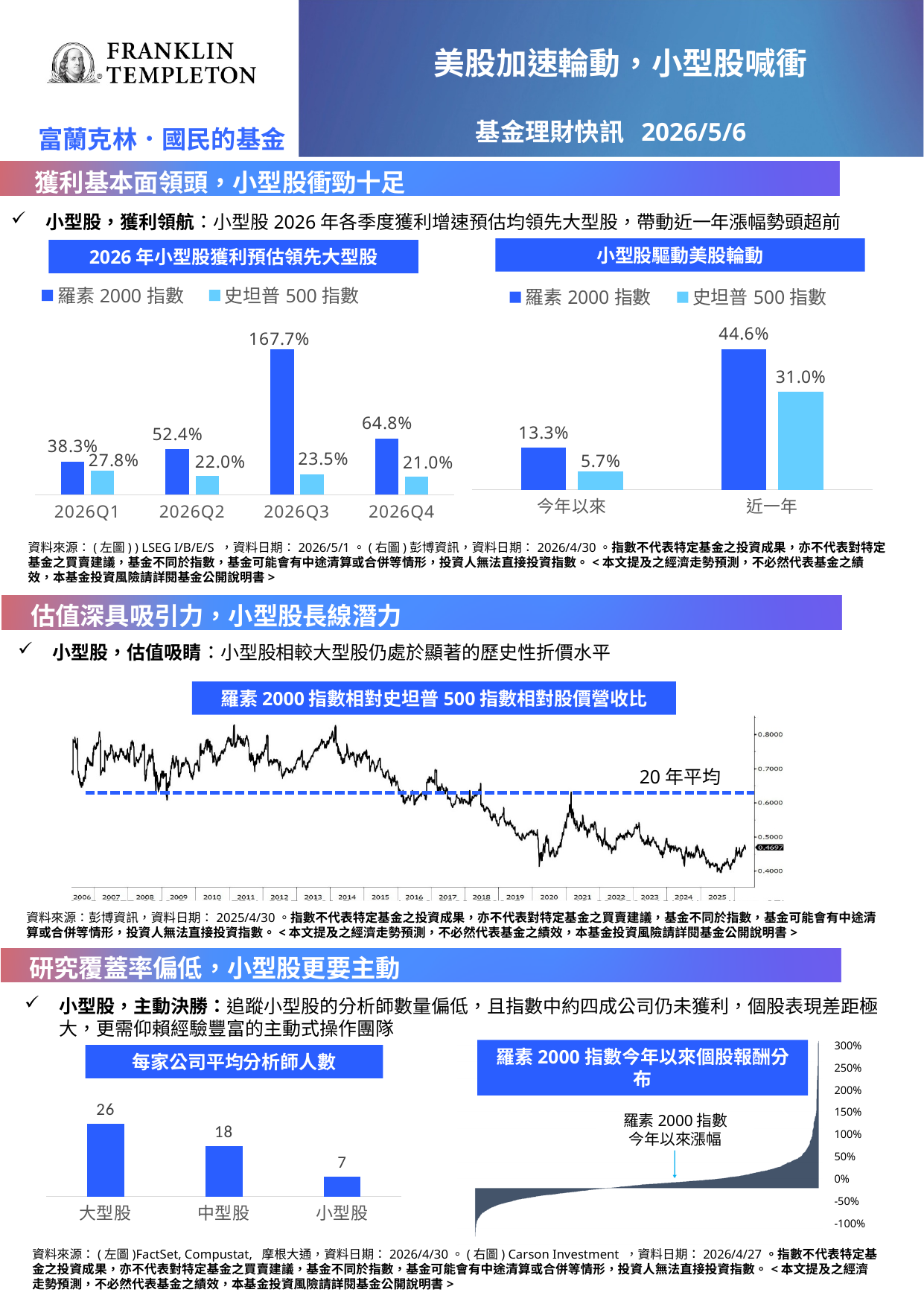
In the chart titled 2026 年小型股獲利預估領先大型股, how many quarters are shown on the x axis? 4 In the chart titled 小型股驅動美股輪動, what is the value for 史坦普 500 指數 for 今年以來? 5.7% In the chart titled 小型股驅動美股輪動, what is the value for 羅素 2000 指數 for 近一年? 44.6% In the chart titled 每家公司平均分析師人數, what is the difference between 大型股 and 中型股? 8 In the chart titled 2026 年小型股獲利預估領先大型股, what is the value for 史坦普 500 指數 in 2026Q4? 21.0% In the chart titled 2026 年小型股獲利預估領先大型股, what is the difference between 羅素 2000 指數 and 史坦普 500 指數 in 2026Q1? 10.5% What kind of chart is the one titled 羅素 2000 指數相對史坦普 500 指數相對股價營收比? Line chart In the chart titled 每家公司平均分析師人數, what is the value for 小型股? 7 In the chart titled 小型股驅動美股輪動, which is larger for 近一年: 羅素 2000 指數 or 史坦普 500 指數? 羅素 2000 指數 In the chart titled 2026 年小型股獲利預估領先大型股, which quarter has the highest value for 羅素 2000 指數? 2026Q3 In the chart titled 小型股驅動美股輪動, how many series does the legend list? 2 In the chart titled 2026 年小型股獲利預估領先大型股, what is the value for 羅素 2000 指數 in 2026Q3? 167.7%